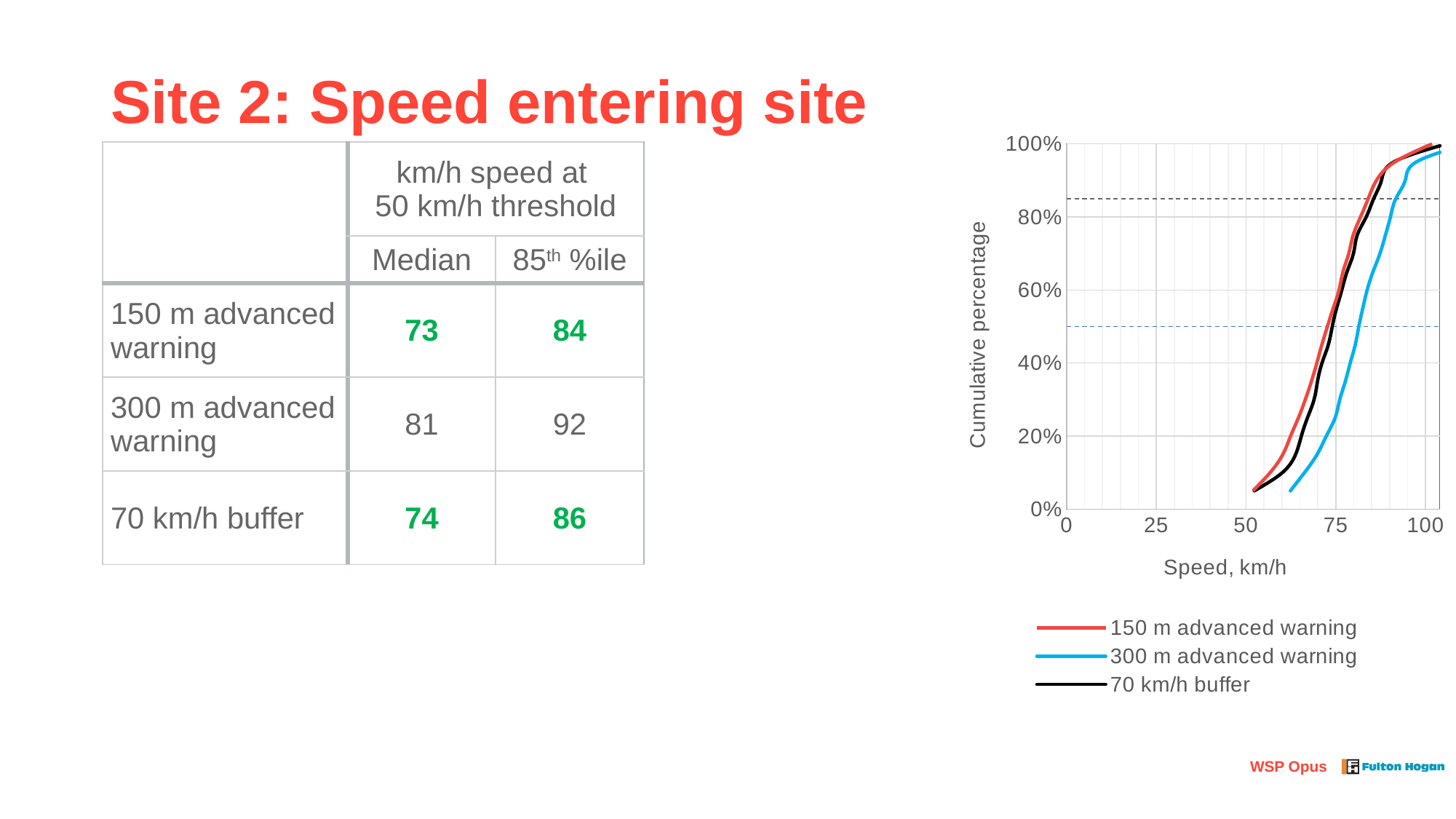
What is the title of the chart's vertical axis? Cumulative percentage At a speed of 100 km/h, is the cumulative percentage for 300 m advanced warning greater or less than 80%? greater At a speed of 60 km/h, is the cumulative percentage for 70 km/h buffer greater or less than 20%? less What kind of chart is shown on the slide? line chart At a speed of 75 km/h, which series has the lowest cumulative percentage? 300 m advanced warning Which series reaches 50% cumulative percentage at the highest speed? 300 m advanced warning At a speed of 75 km/h, is the cumulative percentage for 300 m advanced warning greater or less than 40%? less What is the title of the chart's horizontal axis? Speed, km/h Do the cumulative percentage values rise or fall as speed increases along the x axis? rise At a speed of 75 km/h, which is larger: the cumulative percentage for 150 m advanced warning or for 300 m advanced warning? 150 m advanced warning How many series does the chart's legend list? 3